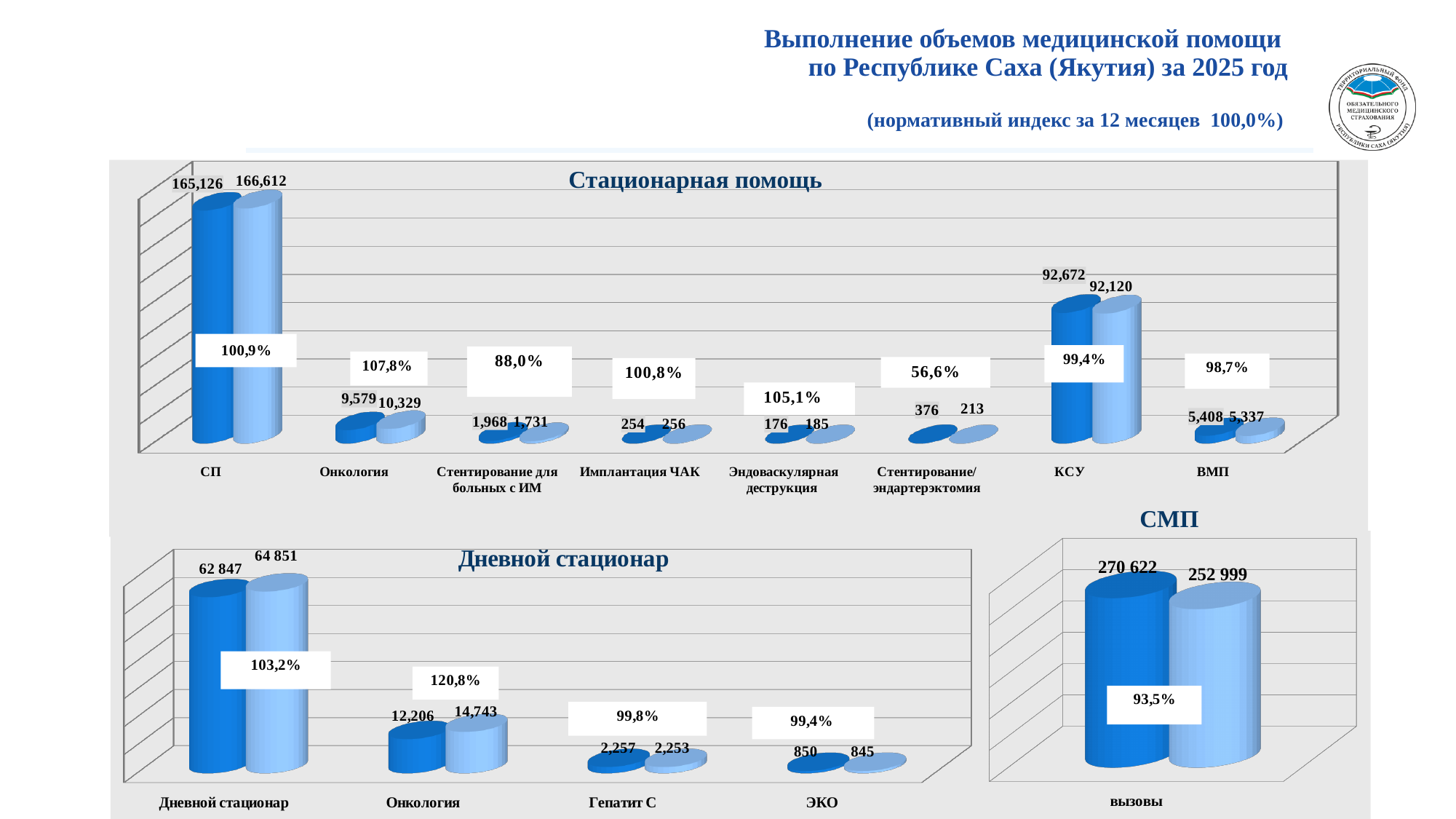
In the 'Дневной стационар' chart, what percentage is shown for Дневной стационар? 103,2% In the 'Дневной стационар' chart, which category has the lowest bars? ЭКО In the 'Стационарная помощь' chart, which category has the highest bars? СП In the 'Стационарная помощь' chart, what value is printed on the light blue bar for КСУ? 92,120 In the 'Дневной стационар' chart, how many categories are shown? 4 In the 'Стационарная помощь' chart, what percentage is shown for Стентирование/эндартерэктомия? 56,6% In the 'Стационарная помощь' chart, what value is printed on the dark blue bar for СП? 165,126 In the 'Стационарная помощь' chart, how many categories are shown on the x axis? 8 In the 'СМП' chart, which bar is larger for вызовы: the dark blue bar (270 622) or the light blue bar (252 999)? dark blue bar What kind of chart is the 'СМП' chart? bar chart In the 'Дневной стационар' chart, what value is printed on the light blue bar for Онкология? 14,743 In the 'Стационарная помощь' chart, what is the difference between the light blue bar (10,329) and the dark blue bar (9,579) for Онкология? 750